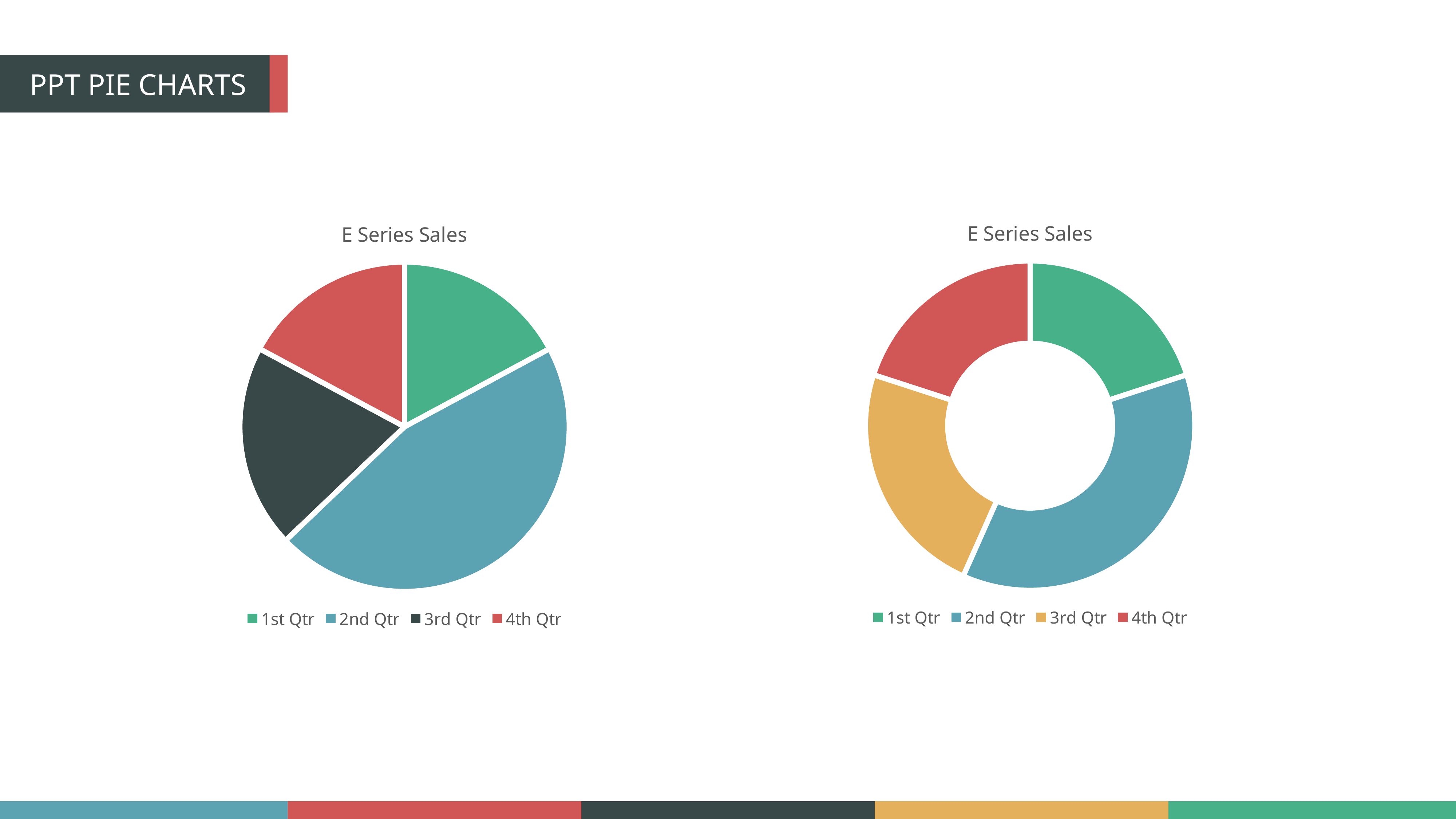
In the right chart, which is larger, the segment for 2nd Qtr or the segment for 3rd Qtr? 2nd Qtr In the right chart, which quarter has the largest segment? 2nd Qtr In the left chart, which quarter has the largest slice? 2nd Qtr How many slices does the left pie chart have? 4 What kind of chart is the chart on the right of the slide? doughnut chart How many categories does the legend of the right chart list? 4 In the right chart, what colour represents 3rd Qtr? yellow In the left chart, which is larger, the slice for 3rd Qtr or the slice for 2nd Qtr? 2nd Qtr What kind of chart is the chart on the left of the slide? pie chart What is the title of the chart on the left? E Series Sales In the left chart, which is larger, the slice for 2nd Qtr or the slice for 1st Qtr? 2nd Qtr